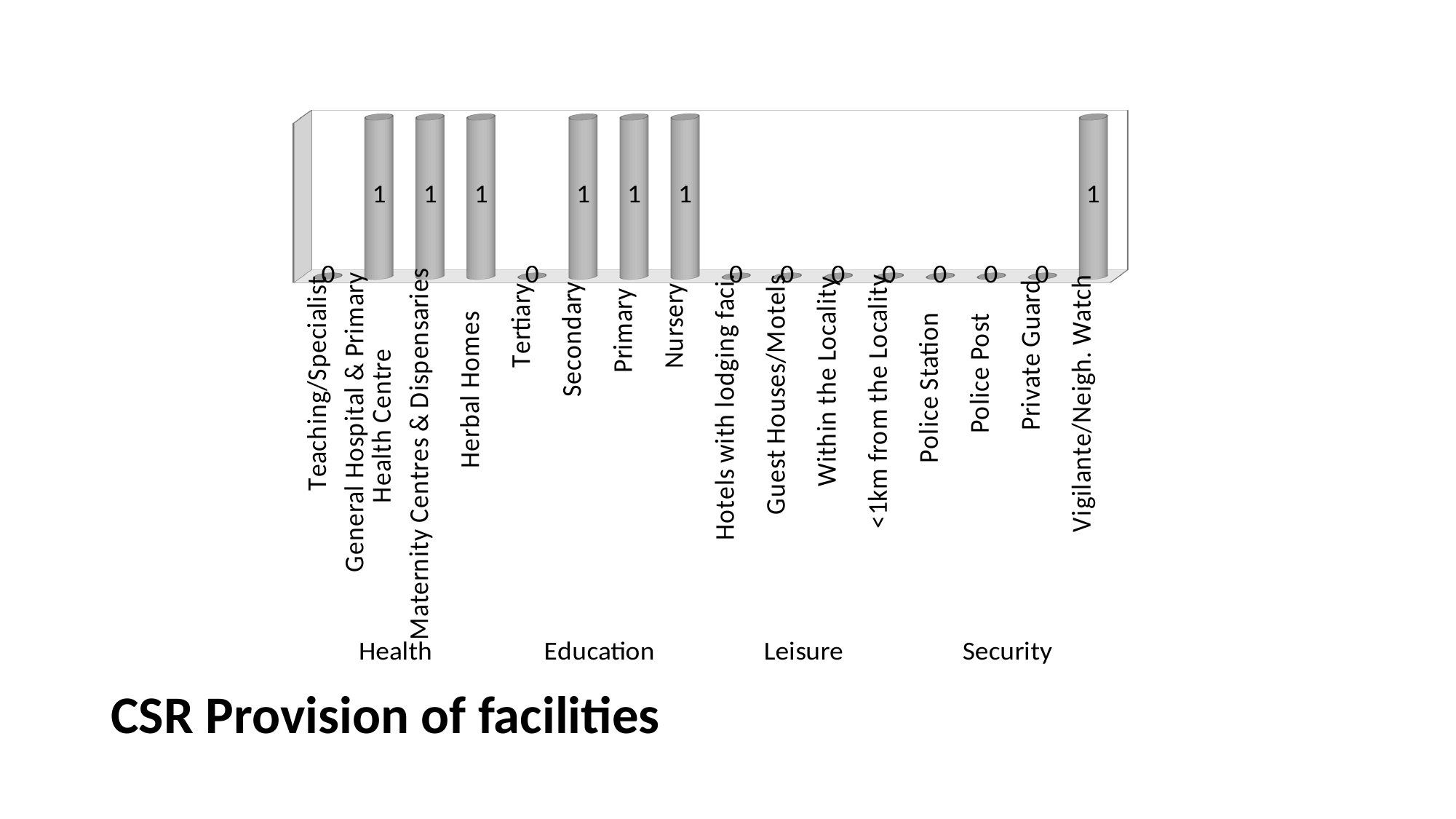
What is the title of the chart? CSR Provision of facilities Which is larger, the value for Nursery or the value for Guest Houses/Motels? Nursery What is the difference between the value for Secondary and the value for Tertiary? 1 How many group labels (such as Health and Education) appear below the category labels? 4 What is the value for Herbal Homes? 1 How many categories are plotted on the chart? 16 How many categories have a value of 1? 7 What kind of chart is shown on the slide? Bar chart What is the value for Police Station? 0 What is the value for Teaching/Specialist? 0 What is the value for Vigilante/Neigh. Watch? 1 What is the value for Tertiary? 0